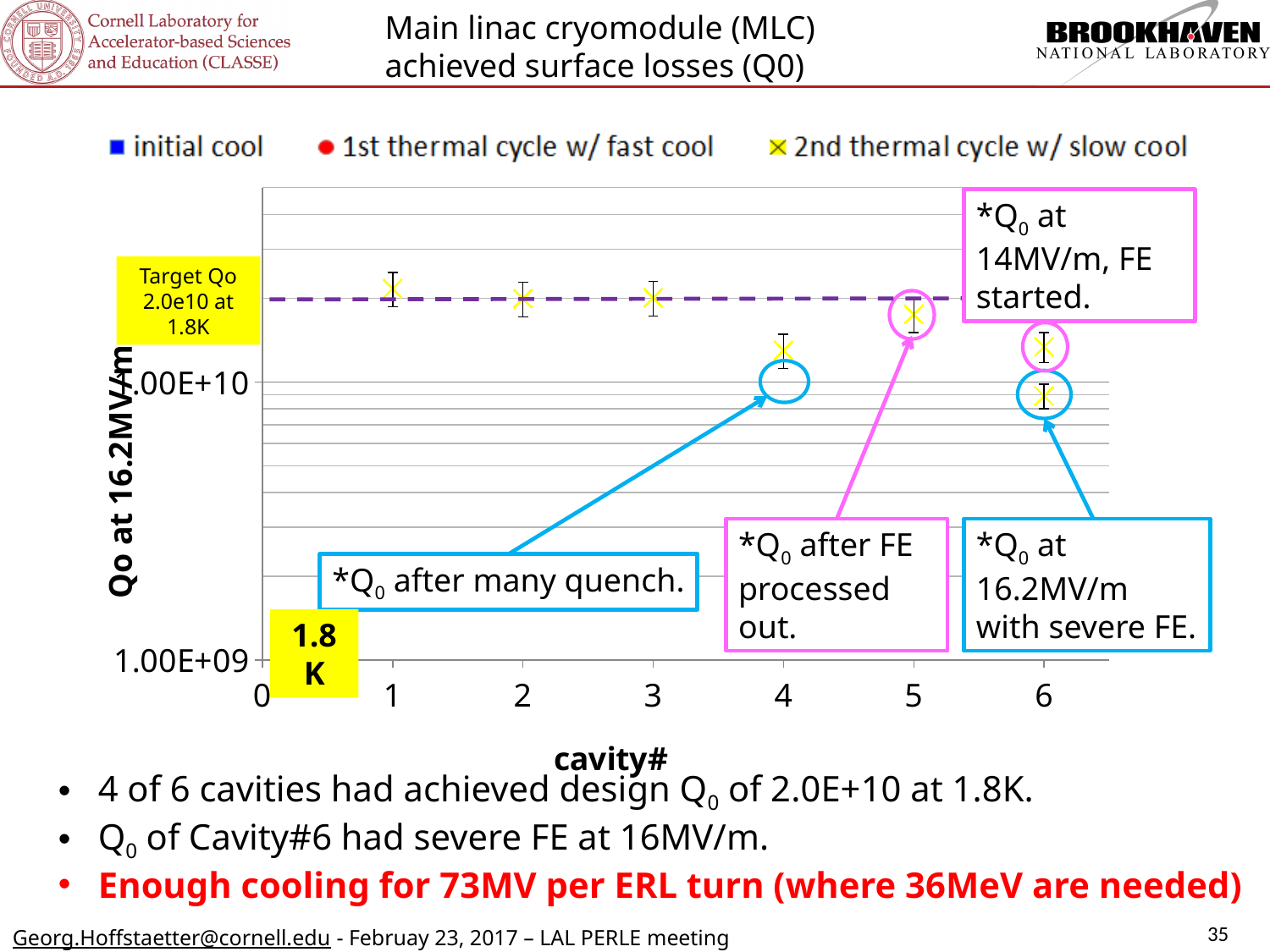
Is the value for cavity 3 greater or less than 1.00E+09? greater What target Qo value does the dashed line on the chart represent? 2.0e10 at 1.8K How many cavities have data points plotted on the chart? 6 Which has the larger plotted Qo value, cavity 1 or cavity 6? cavity 1 How many series does the chart legend list? 3 What is the label of the x axis of the chart? cavity# What kind of chart is shown on the slide? scatter chart Which has the larger plotted Qo value, cavity 3 or cavity 4? cavity 3 What are the three series named in the chart legend? initial cool, 1st thermal cycle w/ fast cool, 2nd thermal cycle w/ slow cool Is the value for cavity 4 greater or less than 1.00E+10? greater Which cavity has the lowest plotted Qo value on the chart? cavity 6 Is the value for cavity 1 greater or less than 1.00E+10? greater